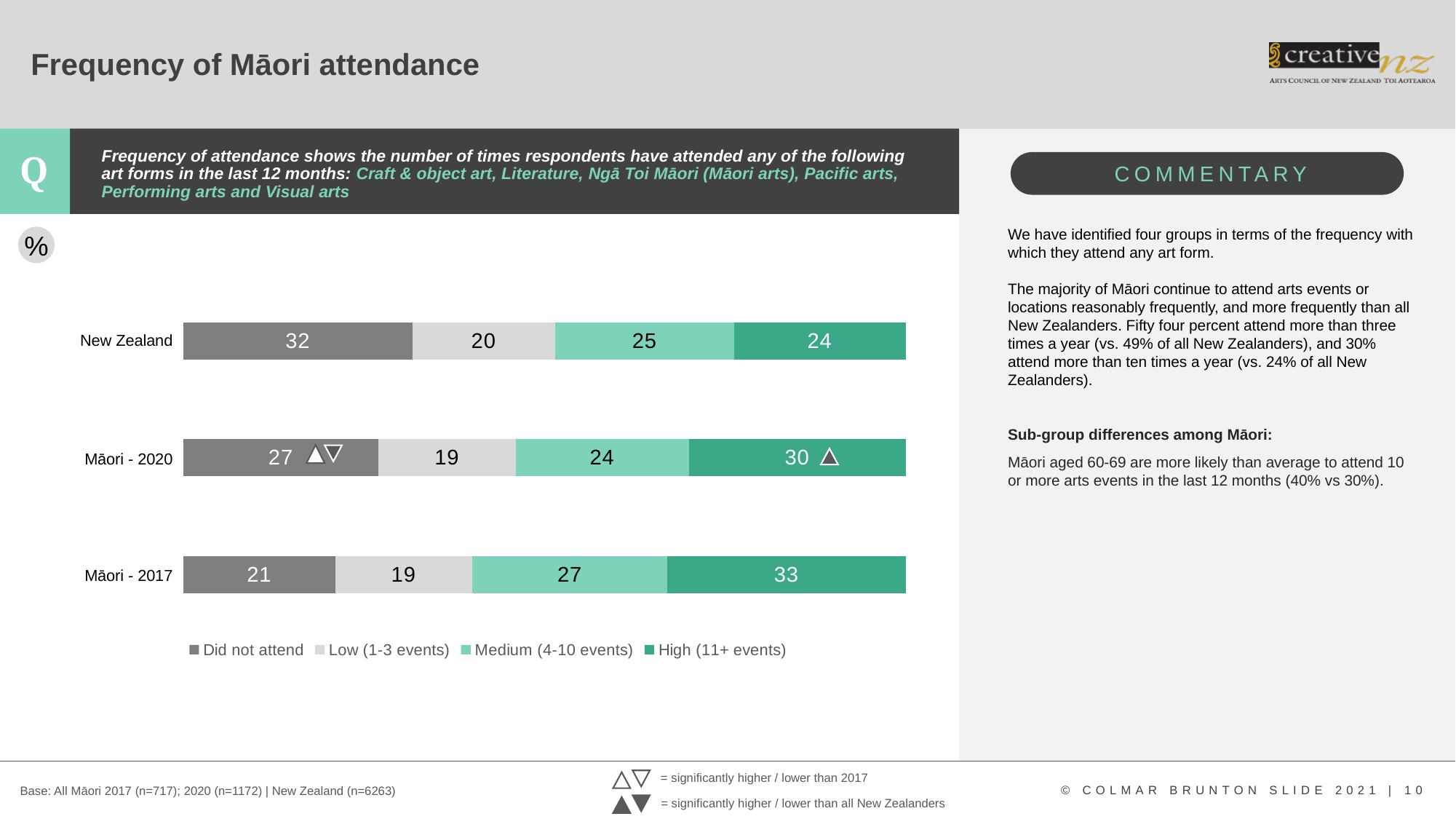
What is the value for Medium (4-10 events) for Māori - 2017? 27 Which category has the highest value for High (11+ events)? Māori - 2017 What is the value for Did not attend for New Zealand? 32 Which is larger: the High (11+ events) value for Māori - 2020 or for New Zealand? Māori - 2020 What is the total of the stacked bar for Māori - 2020? 100 What is the difference between the Did not attend values for New Zealand and Māori - 2017? 11 How many series does the legend list? 4 How many categories are shown on the chart? 3 What is the value for Low (1-3 events) for New Zealand? 20 Which category has the lowest value for Did not attend? Māori - 2017 What is the value for High (11+ events) for Māori - 2020? 30 What kind of chart is shown on the slide? Stacked bar chart